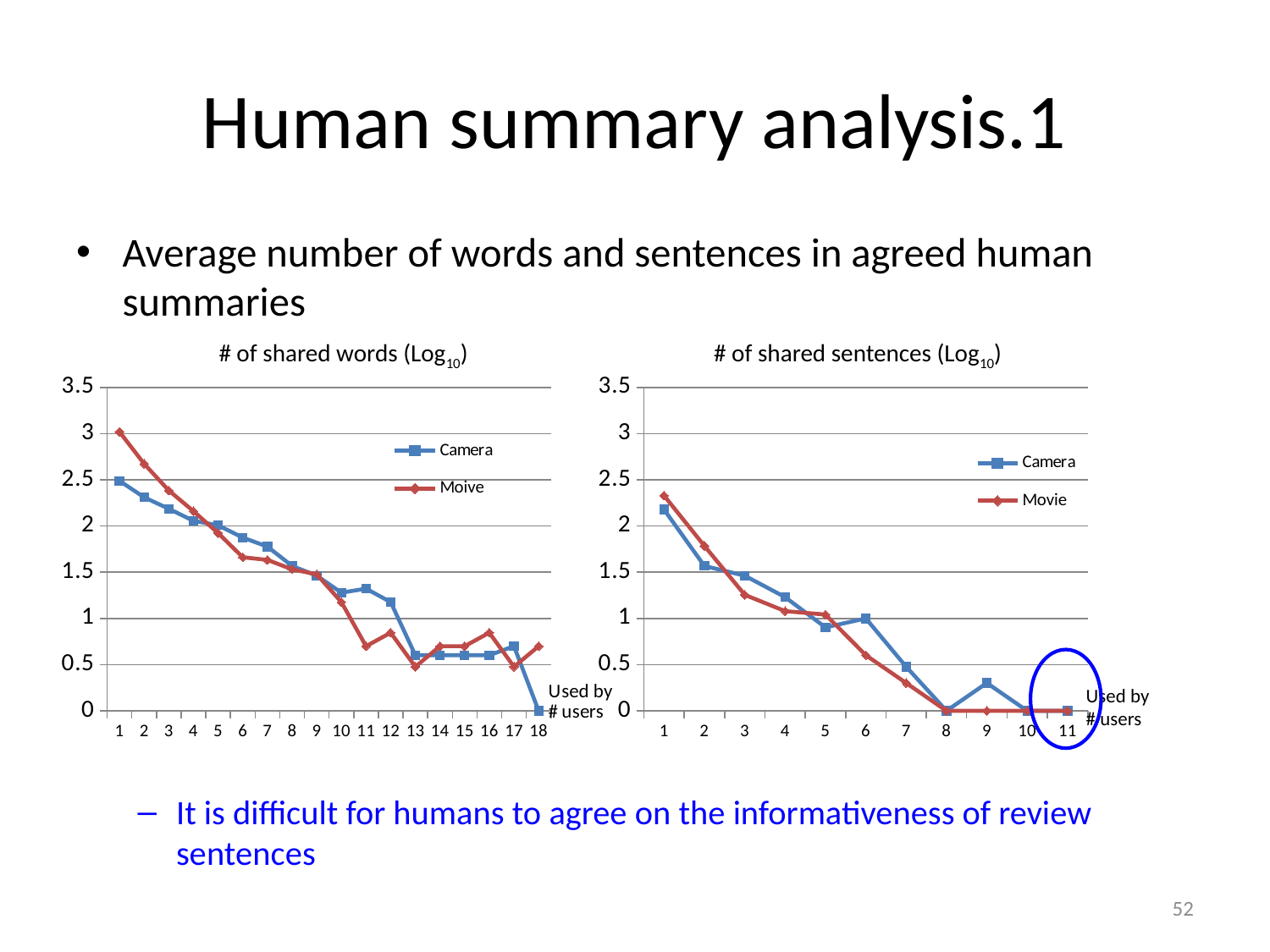
In the '# of shared words (Log10)' chart, do the values generally rise or fall as the number of users increases? fall In the '# of shared words (Log10)' chart, is the Moive value at 1 user greater or less than 2.5? greater In the '# of shared words (Log10)' chart, which series has the higher value at 1 user, Camera or Moive? Moive In the '# of shared sentences (Log10)' chart, which series has the higher value at 9 users, Camera or Movie? Camera In the '# of shared sentences (Log10)' chart, what is the Camera value at 11 users? 0 How many series does the legend of the '# of shared sentences (Log10)' chart list? 2 What kind of chart is the '# of shared words (Log10)' chart? line chart In the '# of shared words (Log10)' chart, is the Moive value at 11 users greater or less than 1? less How many x-axis categories (# users) does the '# of shared words (Log10)' chart have? 18 What are the two legend entries in the '# of shared words (Log10)' chart? Camera and Moive In the '# of shared sentences (Log10)' chart, is the Camera value at 9 users greater or less than 0.5? less How many x-axis categories (# users) does the '# of shared sentences (Log10)' chart have? 11